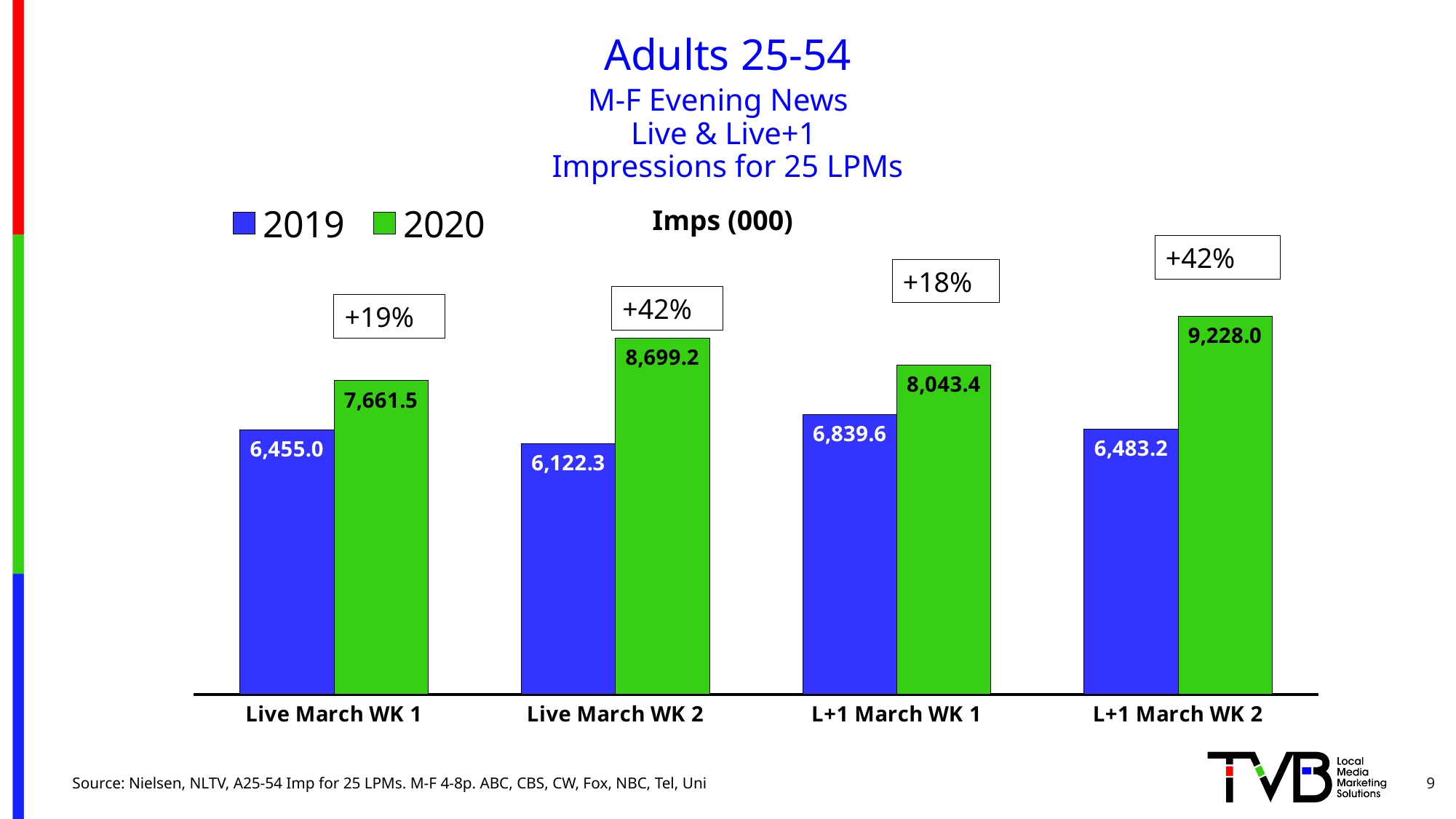
What is the difference between the 2020 and 2019 values for Live March WK 1? 1,206.5 What is the 2020 value for L+1 March WK 2? 9,228.0 What is the difference between the 2020 and 2019 values for L+1 March WK 2? 2,744.8 Which category has the highest 2020 value? L+1 March WK 2 What is the 2020 value for Live March WK 2? 8,699.2 Which category has the highest 2019 value? L+1 March WK 1 What is the 2019 value for Live March WK 1? 6,455.0 How many categories are shown on the x axis? 4 What kind of chart is shown on the slide? Bar chart Which category has the lowest 2019 value? Live March WK 2 How many series does the legend list? 2 Which is larger: the 2019 value for L+1 March WK 1 or the 2019 value for L+1 March WK 2? L+1 March WK 1